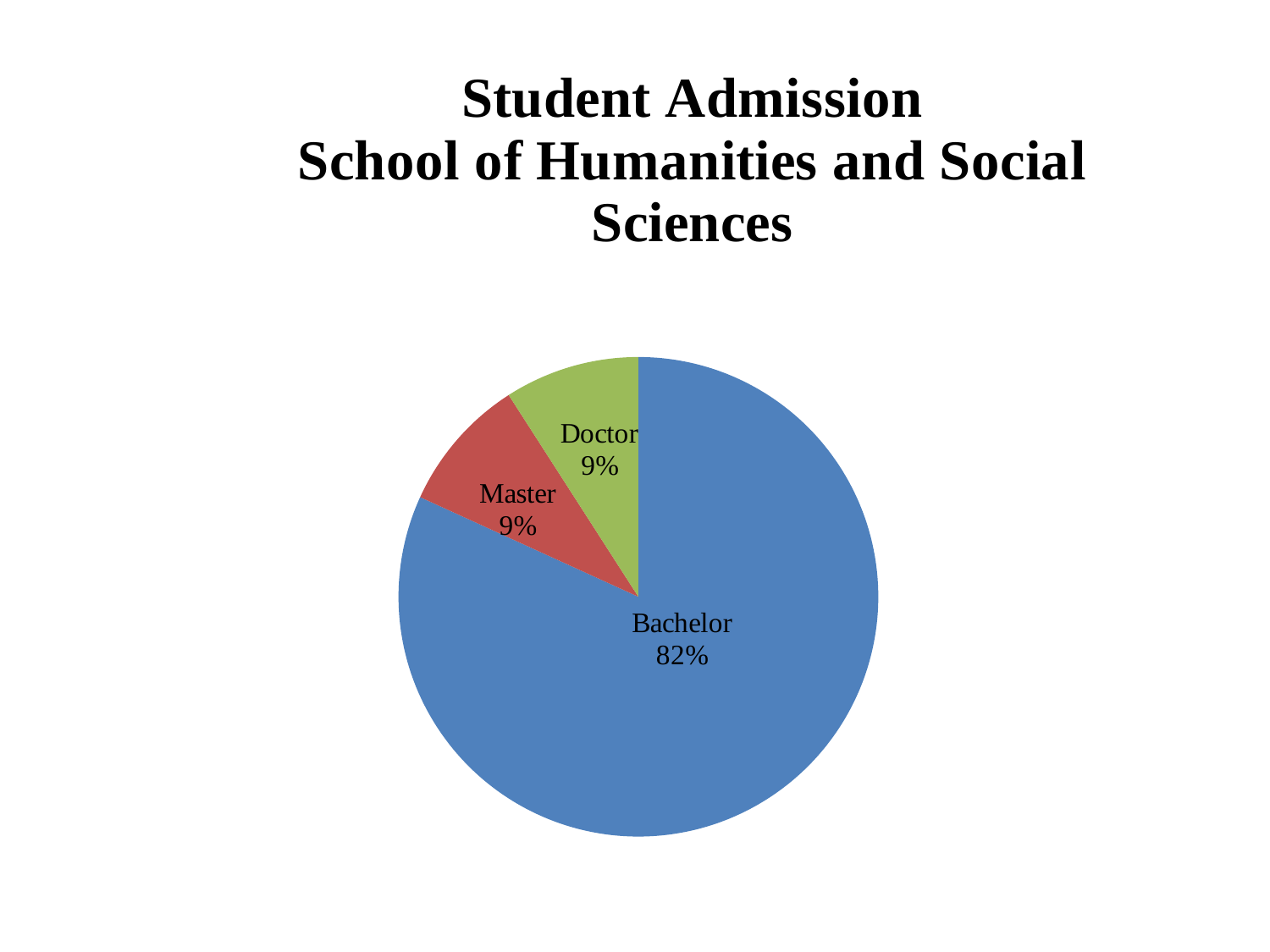
What is the title of the chart? Student Admission School of Humanities and Social Sciences What type of chart is shown on the slide? pie chart What colour is the Bachelor slice? blue Which category has the largest slice of the pie? Bachelor What share of the pie does Doctor represent? 9% What share of the pie does Bachelor represent? 82% What is the difference in percentage points between the Bachelor and Master slices? 73 What is the combined share of the Master and Doctor slices? 18% Is the share for Bachelor greater or less than 50%? greater What share of the pie does Master represent? 9% Which is larger, the Bachelor slice or the Doctor slice? Bachelor How many slices does the pie chart have? 3